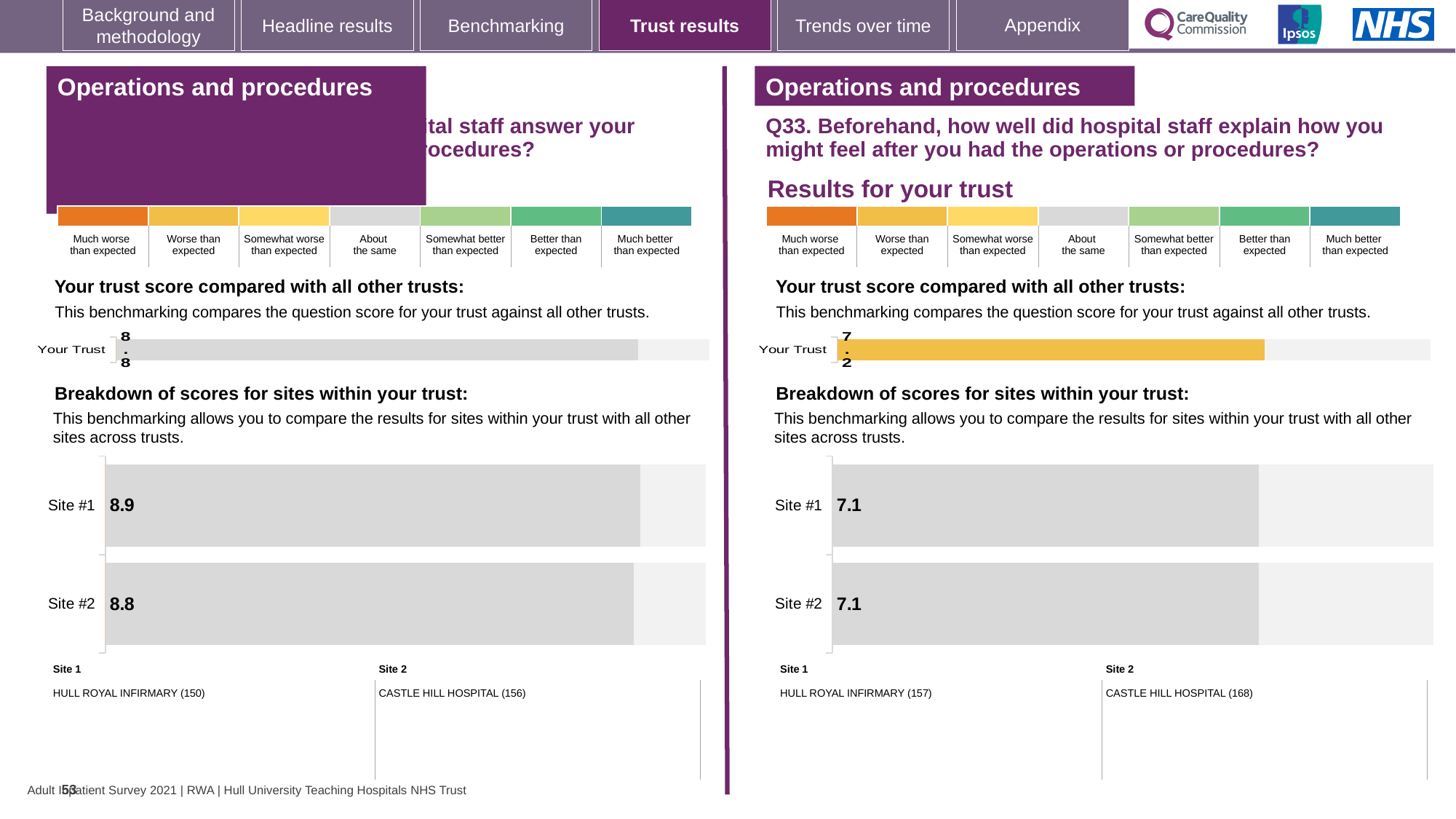
On the left side of the slide, what is the 'Your Trust' score in the trust score comparison chart? 8.8 In the Q33 site breakdown chart on the right side of the slide, what is the score for Site #2? 7.1 On the left side of the slide, what is the score shown for Site #2 in the breakdown of scores for sites within your trust? 8.8 On the left side of the slide, which site has the higher score in the site breakdown chart? Site #1 In the Q33 site breakdown chart on the right side of the slide, what is the score for Site #1? 7.1 What type of chart is used for the site breakdown on the right side of the slide? Bar chart In the Q33 chart on the right side of the slide, what colour is the 'Your Trust' bar? Yellow On the left side of the slide, what is the difference between the Site #1 and Site #2 scores in the site breakdown chart? 0.1 On the left side of the slide, what is the score shown for Site #1 in the breakdown of scores for sites within your trust? 8.9 In the Q33 chart on the right side of the slide, what is the 'Your Trust' score? 7.2 What is the difference between the 'Your Trust' score on the left side of the slide and the 'Your Trust' score in the Q33 chart on the right? 1.6 How many sites are shown in the Q33 site breakdown chart on the right side of the slide? 2